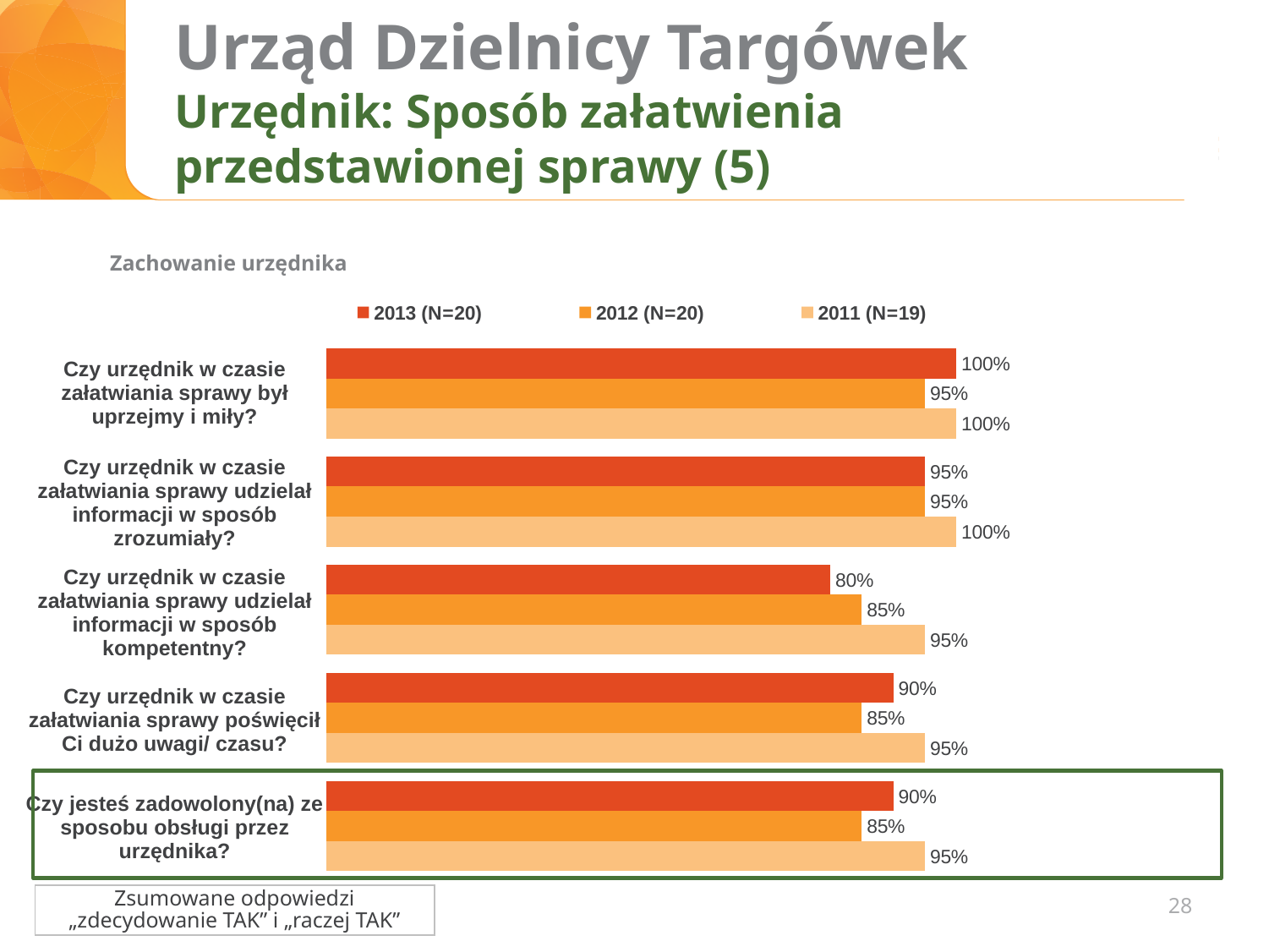
What kind of chart is shown on the slide? Bar chart Which category has the lowest 2013 (N=20) value? Czy urzędnik w czasie załatwiania sprawy udzielał informacji w sposób kompetentny? What is the title of the chart? Zachowanie urzędnika Which is larger for "Czy urzędnik w czasie załatwiania sprawy był uprzejmy i miły?": the 2013 (N=20) value or the 2012 (N=20) value? 2013 (N=20) Which series is shown in the lightest colour in the legend? 2011 (N=19) What is the 2011 (N=19) value for "Czy jesteś zadowolony(na) ze sposobu obsługi przez urzędnika?"? 95% What is the 2013 (N=20) value for "Czy urzędnik w czasie załatwiania sprawy był uprzejmy i miły?"? 100% How many question categories are shown on the chart? 5 What is the 2012 (N=20) value for "Czy urzędnik w czasie załatwiania sprawy udzielał informacji w sposób kompetentny?"? 85% What is the difference between the 2011 (N=19) and 2013 (N=20) values for "Czy urzędnik w czasie załatwiania sprawy udzielał informacji w sposób kompetentny?"? 15% What is the 2013 (N=20) value for "Czy urzędnik w czasie załatwiania sprawy poświęcił Ci dużo uwagi/ czasu?"? 90% How many series does the legend list? 3